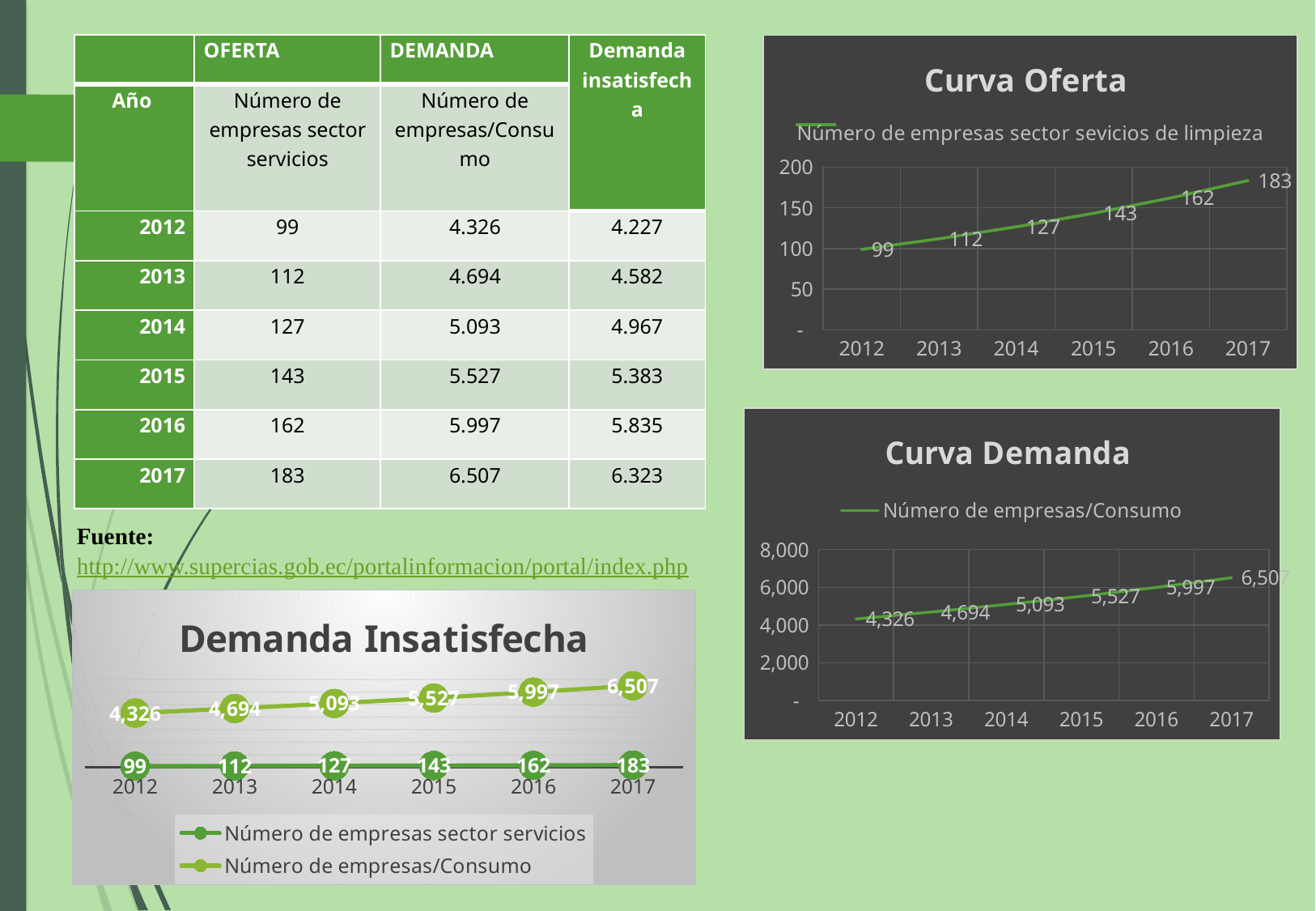
In the Curva Oferta chart, what is the value for 2014? 127 In the Demanda Insatisfecha chart, which is larger in 2016: Número de empresas sector servicios or Número de empresas/Consumo? Número de empresas/Consumo In the Curva Oferta chart, do the values rise or fall from 2012 to 2017? rise In the Curva Oferta chart, how many years are plotted on the x axis? 6 In the Curva Oferta chart, what is the difference between the values for 2017 and 2012? 84 In the Demanda Insatisfecha chart, what is the value of Número de empresas/Consumo for 2013? 4,694 In the Curva Demanda chart, which year has the lowest value? 2012 In the Curva Oferta chart, which year has the highest value? 2017 In the Curva Demanda chart, what is the value for 2015? 5,527 In the Curva Demanda chart, is the value for 2017 greater or less than 6,000? greater In the Demanda Insatisfecha chart, how many series does the legend list? 2 What kind of chart is the Curva Demanda chart? line chart